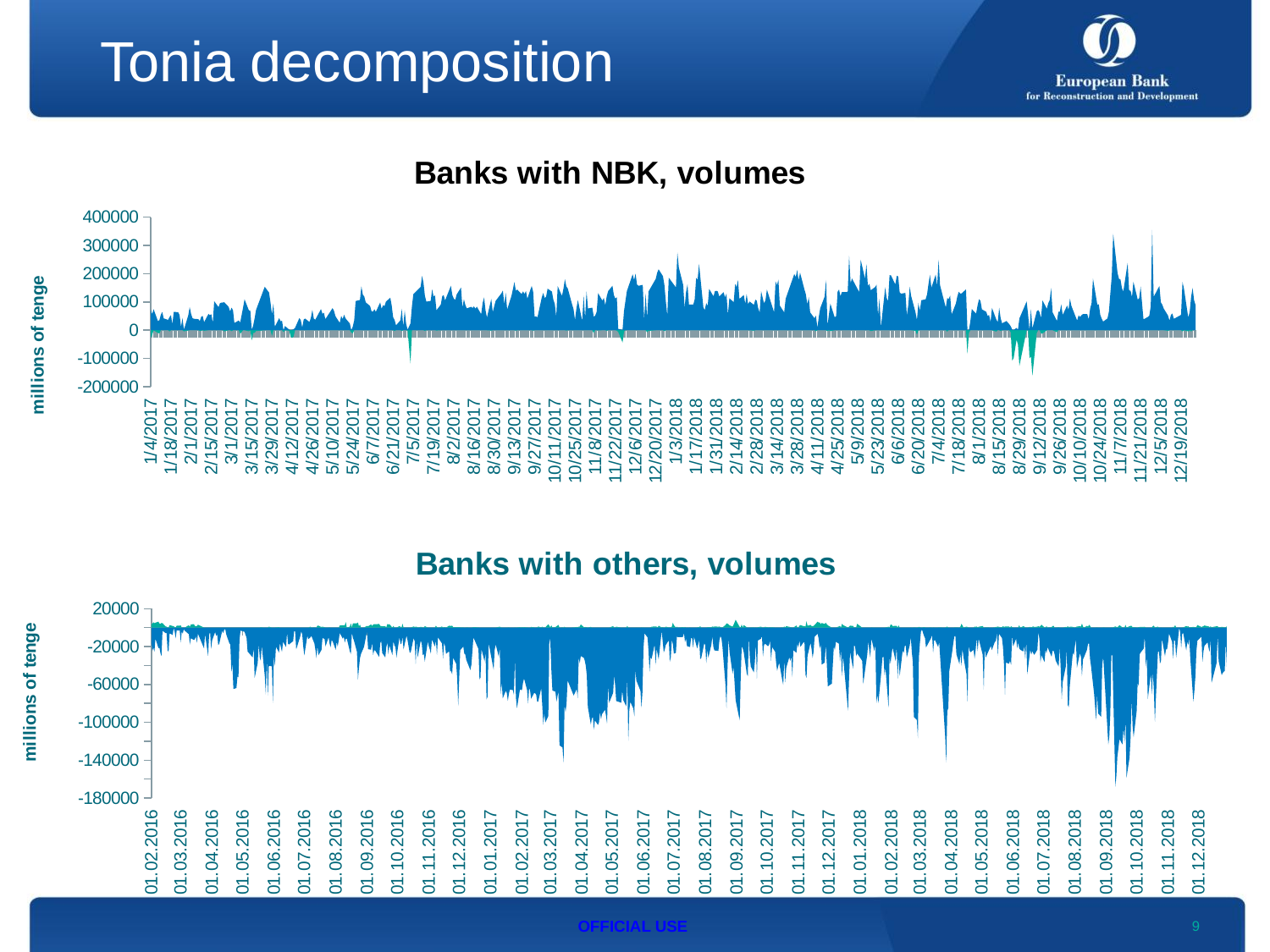
How many charts are shown on the slide? 2 What is the y-axis label of the "Banks with NBK, volumes" chart? millions of tenge In the "Banks with others, volumes" chart, are the values for most dates greater or less than 0? less In the "Banks with others, volumes" chart, is the trough around 01.03.2017 greater or less than -60000? less In the "Banks with NBK, volumes" chart, are the values for most dates greater or less than 0? greater What is the title of the lower chart on the slide? Banks with others, volumes What kind of chart is the "Banks with NBK, volumes" chart? area chart What is the highest y-axis tick value shown on the "Banks with NBK, volumes" chart? 400000 What is the lowest y-axis tick value shown on the "Banks with others, volumes" chart? -180000 What is the first date label on the x-axis of the "Banks with others, volumes" chart? 01.02.2016